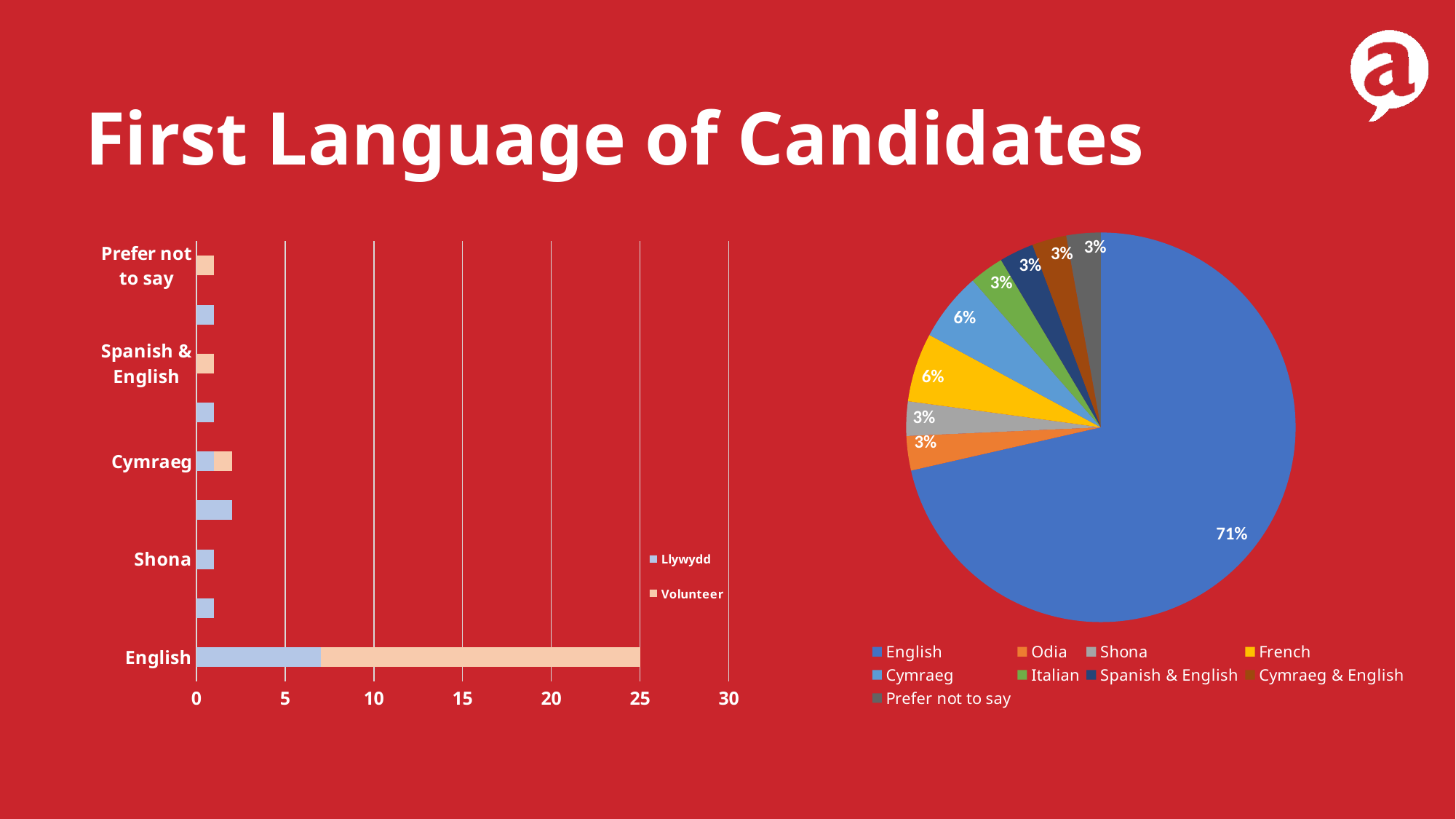
In the bar chart on the left, is the value for Shona greater or less than 5? less How many languages are listed in the pie chart's legend? 9 In the bar chart on the left, which category has the longest bar? English In the pie chart, what percentage is shown for French? 6% In the pie chart, what share of candidates have English as their first language? 71% How many series does the legend of the bar chart on the left list? 2 In the pie chart, what percentage is shown for Cymraeg? 6% What type of chart is the chart on the left of the slide? bar chart In the bar chart on the left, is the total stacked value for English greater or less than 20? greater In the pie chart, which slice is larger, French or Odia? French In the pie chart, what is the difference in percentage points between the English slice and the French slice? 65% In the pie chart, which language has the largest slice? English